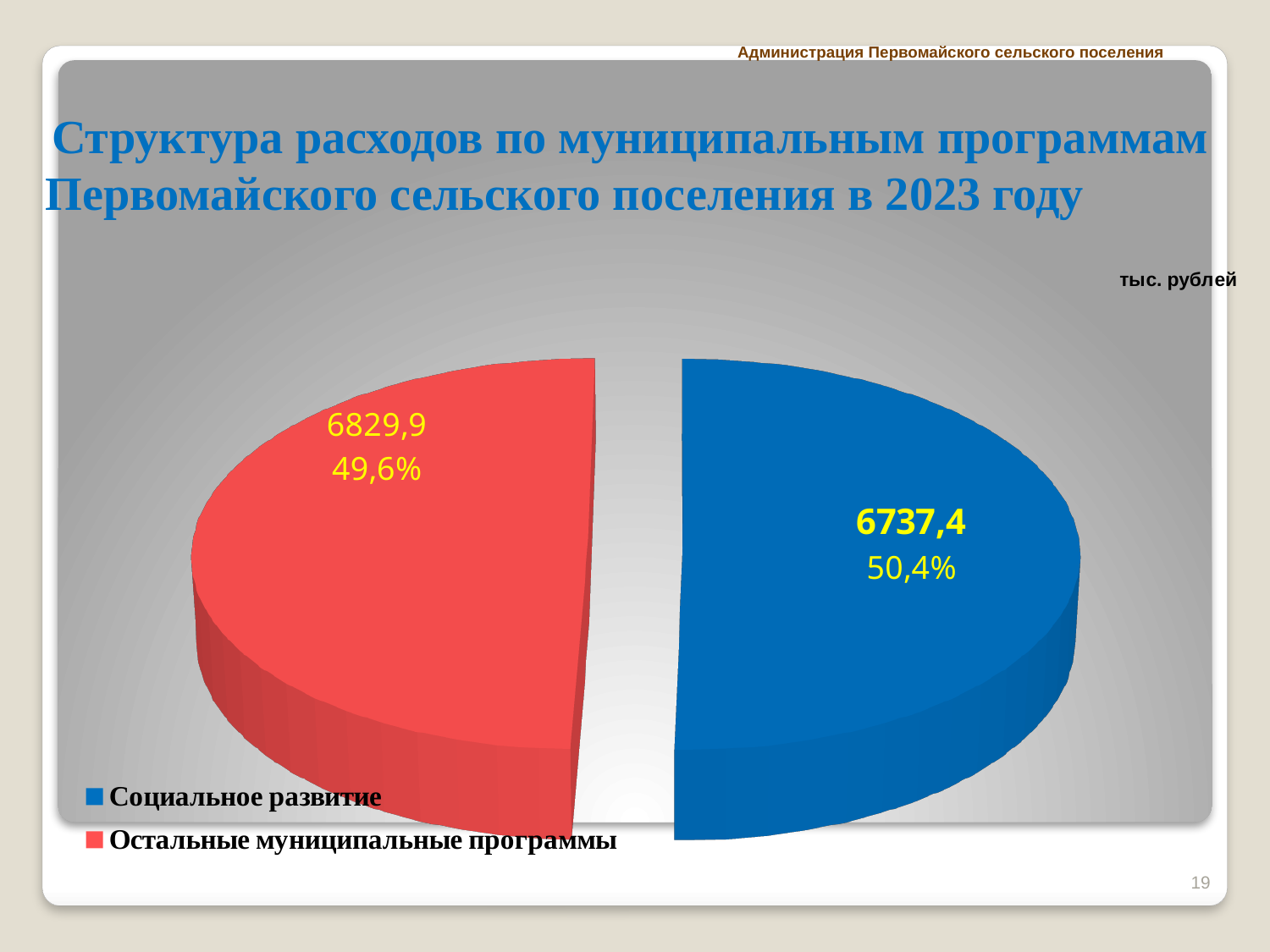
How many slices does the pie chart have? 2 What is the value shown for Остальные муниципальные программы? 6829,9 What percentage share is shown for Остальные муниципальные программы? 49,6% What percentage share is shown for Социальное развитие? 50,4% What unit is indicated for the values in the chart? тыс. рублей Which slice has the larger printed percentage share? Социальное развитие What is the value shown for Социальное развитие? 6737,4 What is the difference between the printed values for Остальные муниципальные программы and Социальное развитие? 92,5 How many entries does the legend list? 2 What colour is the slice for Социальное развитие? blue What kind of chart is shown on the slide? pie chart Which slice has the larger printed value in thousand rubles, Социальное развитие or Остальные муниципальные программы? Остальные муниципальные программы